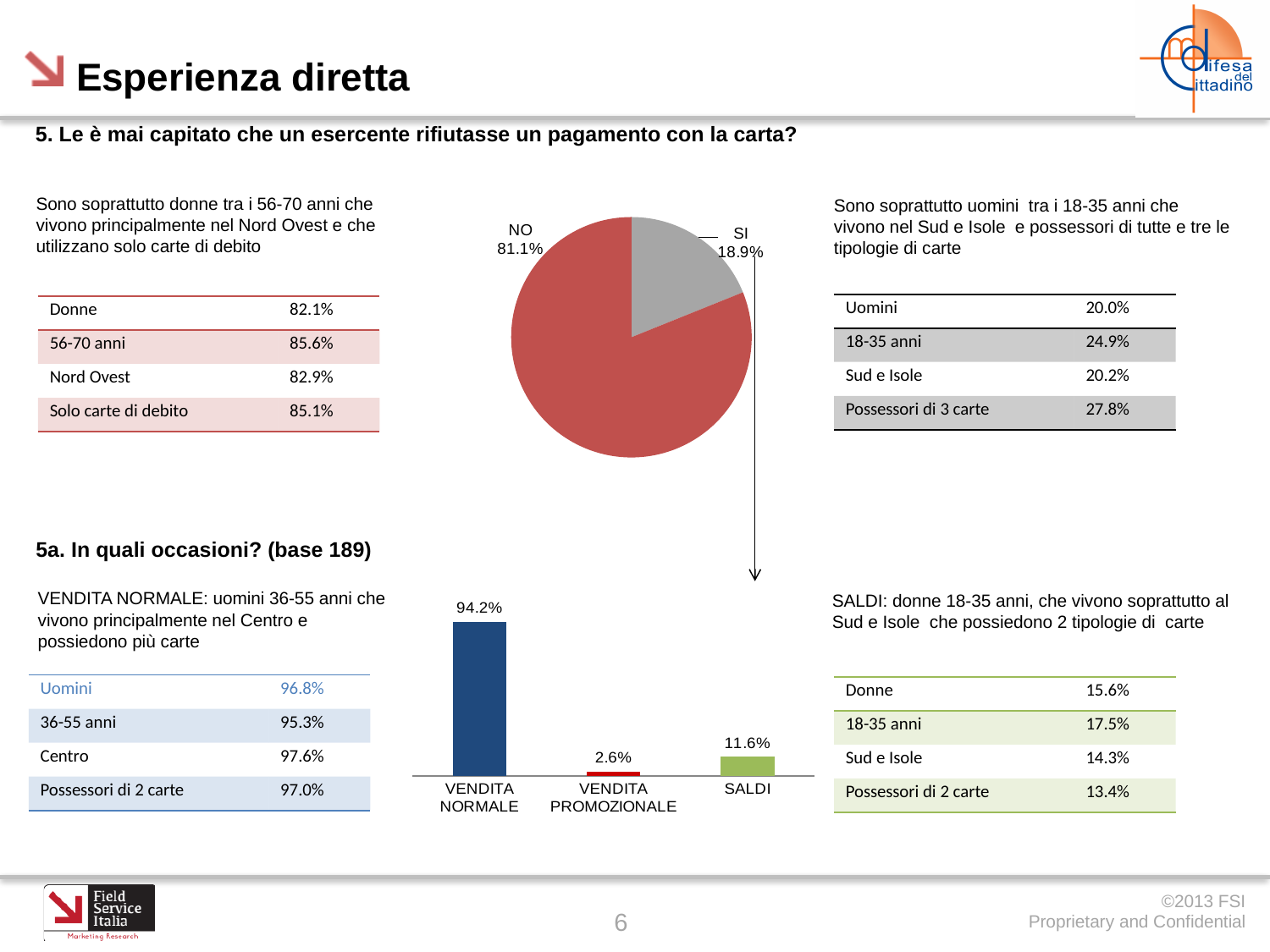
In the bar chart at the bottom of the slide, which category has the lowest value? VENDITA PROMOZIONALE In the bar chart at the bottom of the slide, what is the value for VENDITA PROMOZIONALE? 2.6% How many slices does the pie chart at the top of the slide have? 2 In the pie chart at the top of the slide, what share is labelled NO? 81.1% In the pie chart at the top of the slide, what is the difference between the NO and SI shares? 62.2% In the pie chart at the top of the slide, what share is labelled SI? 18.9% In the bar chart at the bottom of the slide, what is the difference between VENDITA NORMALE and SALDI? 82.6% In the pie chart at the top of the slide, which slice is larger, NO or SI? NO In the bar chart at the bottom of the slide, what is the value for VENDITA NORMALE? 94.2% In the bar chart at the bottom of the slide, what is the value for SALDI? 11.6% What kind of chart is the chart at the bottom centre of the slide? bar chart What kind of chart is the chart at the top centre of the slide? pie chart